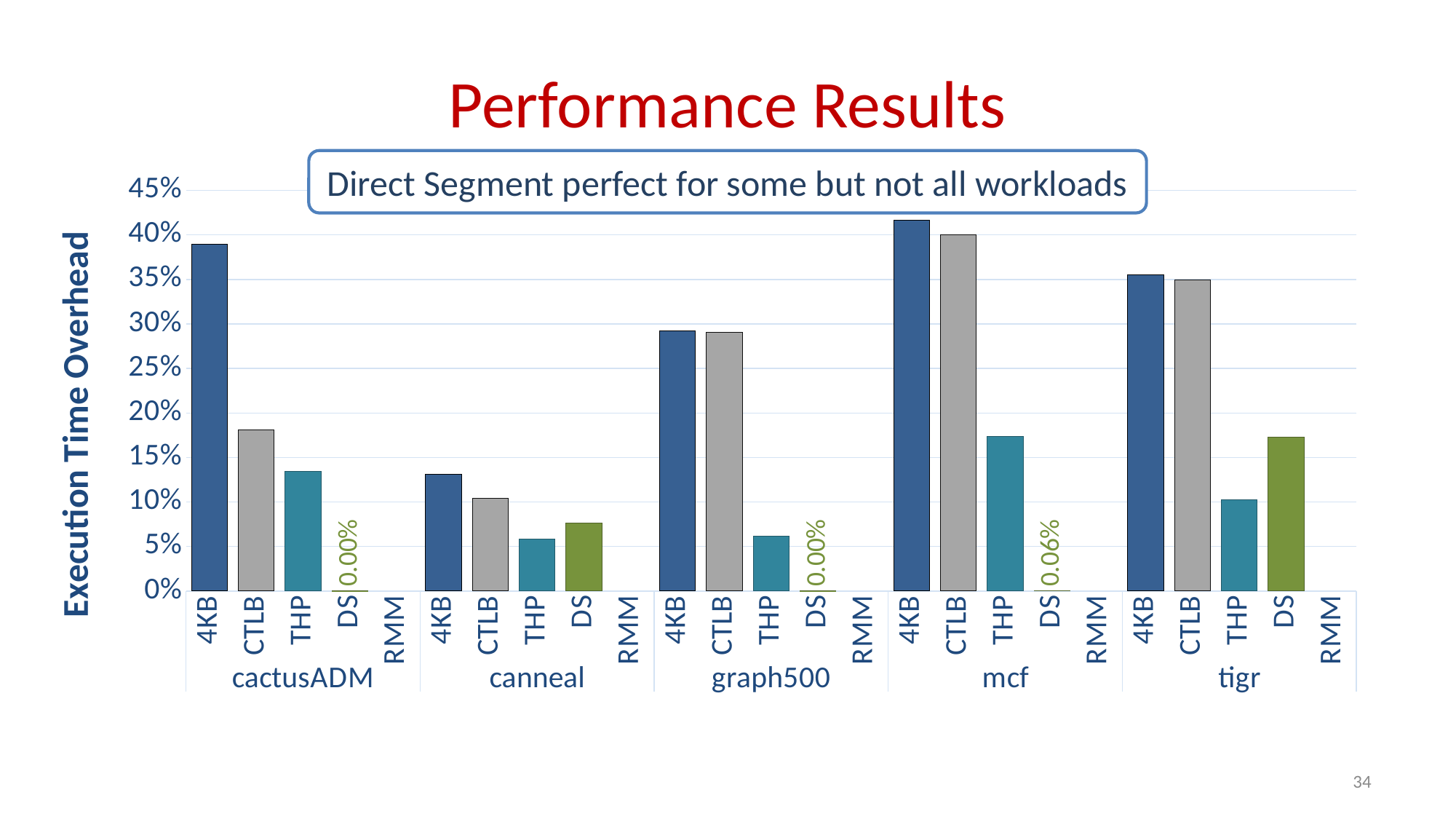
What type of chart is shown on the slide? bar chart What is the Execution Time Overhead for DS in the graph500 workload? 0.00% Is the value for 4KB in cactusADM greater or less than 35%? greater Which workload has the highest 4KB bar? mcf Which workload has the lowest 4KB bar? canneal What is the Execution Time Overhead for DS in the mcf workload? 0.06% What is the title of the y axis? Execution Time Overhead What is the Execution Time Overhead for DS in the cactusADM workload? 0.00% In the tigr workload, which is larger, THP or DS? DS Is the value for DS in tigr greater or less than 15%? greater Is the value for CTLB in canneal greater or less than 15%? less How many workloads are shown along the x axis? 5